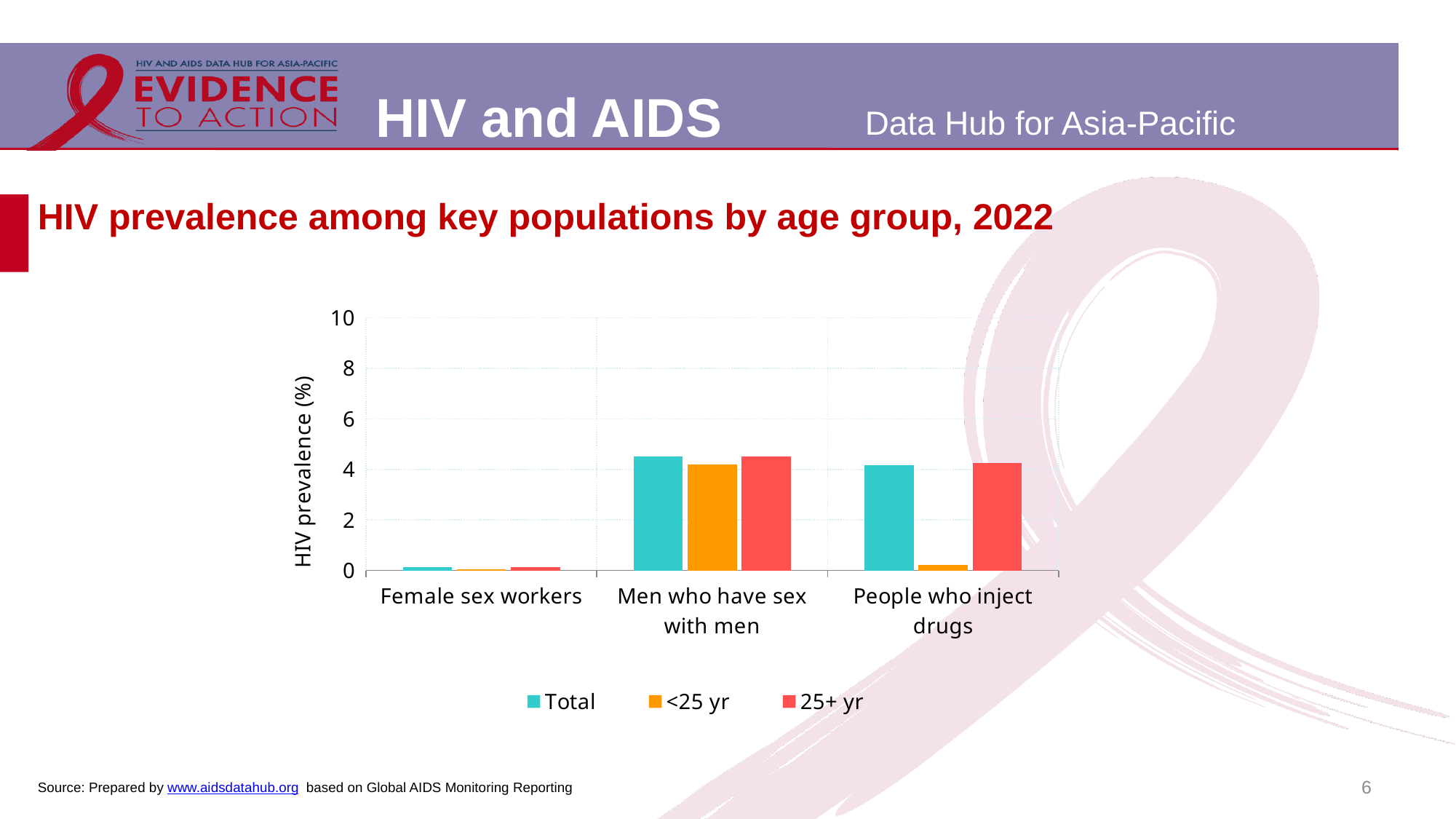
What type of chart is shown on the slide? bar chart For People who inject drugs, which is larger: the <25 yr value or the 25+ yr value? 25+ yr Is the <25 yr value for People who inject drugs greater or less than 2? less Is the Total value for Female sex workers greater or less than 2? less Which key population has the lowest Total value? Female sex workers What is the title of the chart? HIV prevalence among key populations by age group, 2022 How many series does the legend list? 3 Which key population has the highest <25 yr value? Men who have sex with men What is the label of the vertical axis? HIV prevalence (%) How many key population categories are shown on the x axis? 3 Is the 25+ yr value for Men who have sex with men greater or less than 6? less